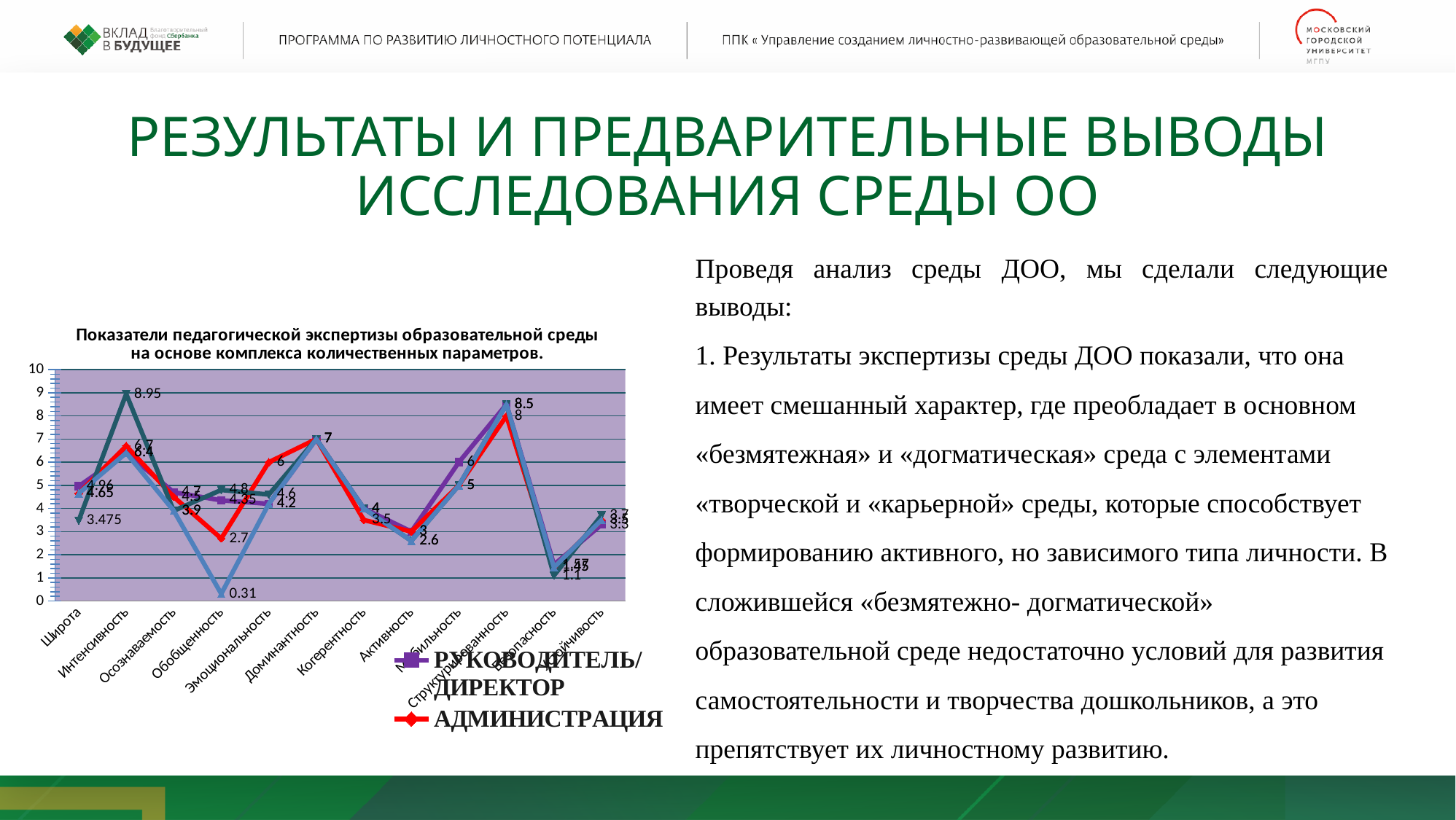
Is the value of the АДМИНИСТРАЦИЯ (red) line at Обобщенность greater or less than 4? less What is the value of the АДМИНИСТРАЦИЯ (red) line at Эмоциональность? 6 What type of chart is shown on the slide? line chart Which category has the higher peak value: Интенсивность or Структурированность? Интенсивность What value do all the lines converge to at Доминантность? 7 What is the title of the chart? Показатели педагогической экспертизы образовательной среды на основе комплекса количественных параметров. What is the difference between the highest labeled value (8.95) and the lowest labeled value (0.31) on the chart? 8.64 Which two series names are readable in the chart legend? РУКОВОДИТЕЛЬ/ДИРЕКТОР and АДМИНИСТРАЦИЯ What is the highest value labeled on the chart, and at which category does it occur? 8.95 at Интенсивность Is the value of the АДМИНИСТРАЦИЯ (red) line at Структурированность greater or less than 7? greater What is the lowest value labeled on the chart, and at which category does it occur? 0.31 at Обобщенность What is the value of the АДМИНИСТРАЦИЯ (red) line at Обобщенность? 2.7